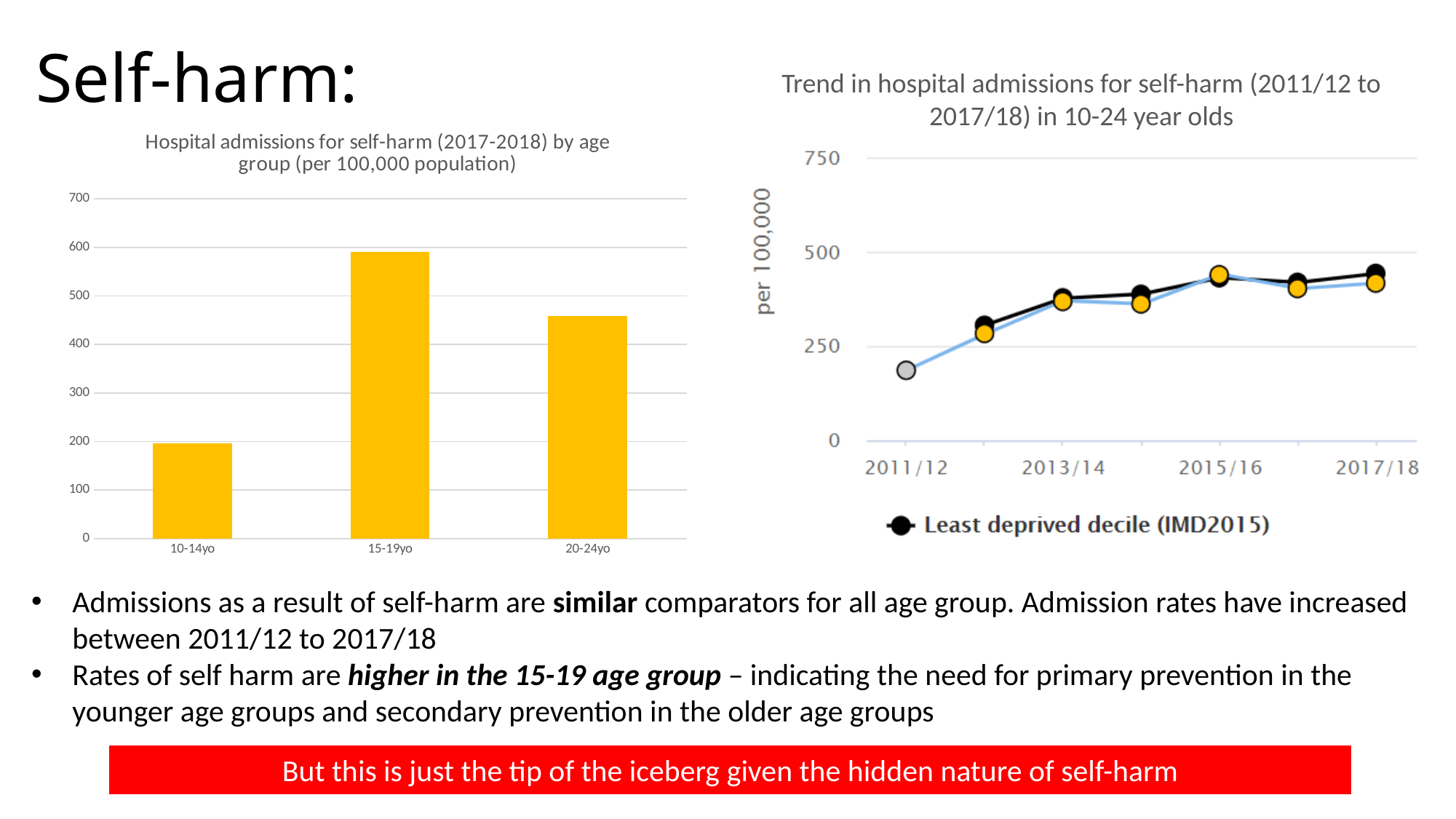
In the bar chart on the left, which age group has the lowest admission rate? 10-14yo In the bar chart on the left, which age group has the highest admission rate? 15-19yo In the bar chart on the left, which age group has a higher admission rate: 20-24yo or 10-14yo? 20-24yo In the bar chart on the left, is the value for 15-19yo greater or less than 500? greater In the bar chart on the left, is the value for 20-24yo greater or less than 400? greater What is the legend entry shown below the line chart on the right? Least deprived decile (IMD2015) What kind of chart is the 'Hospital admissions for self-harm (2017-2018) by age group' chart on the left? bar chart How many age groups are shown in the bar chart on the left? 3 In the line chart on the right, is the value for 2011/12 greater or less than 250? less What kind of chart is the 'Trend in hospital admissions for self-harm (2011/12 to 2017/18) in 10-24 year olds' chart on the right? line chart In the line chart on the right, do admission rates generally rise or fall from 2011/12 to 2017/18? rise